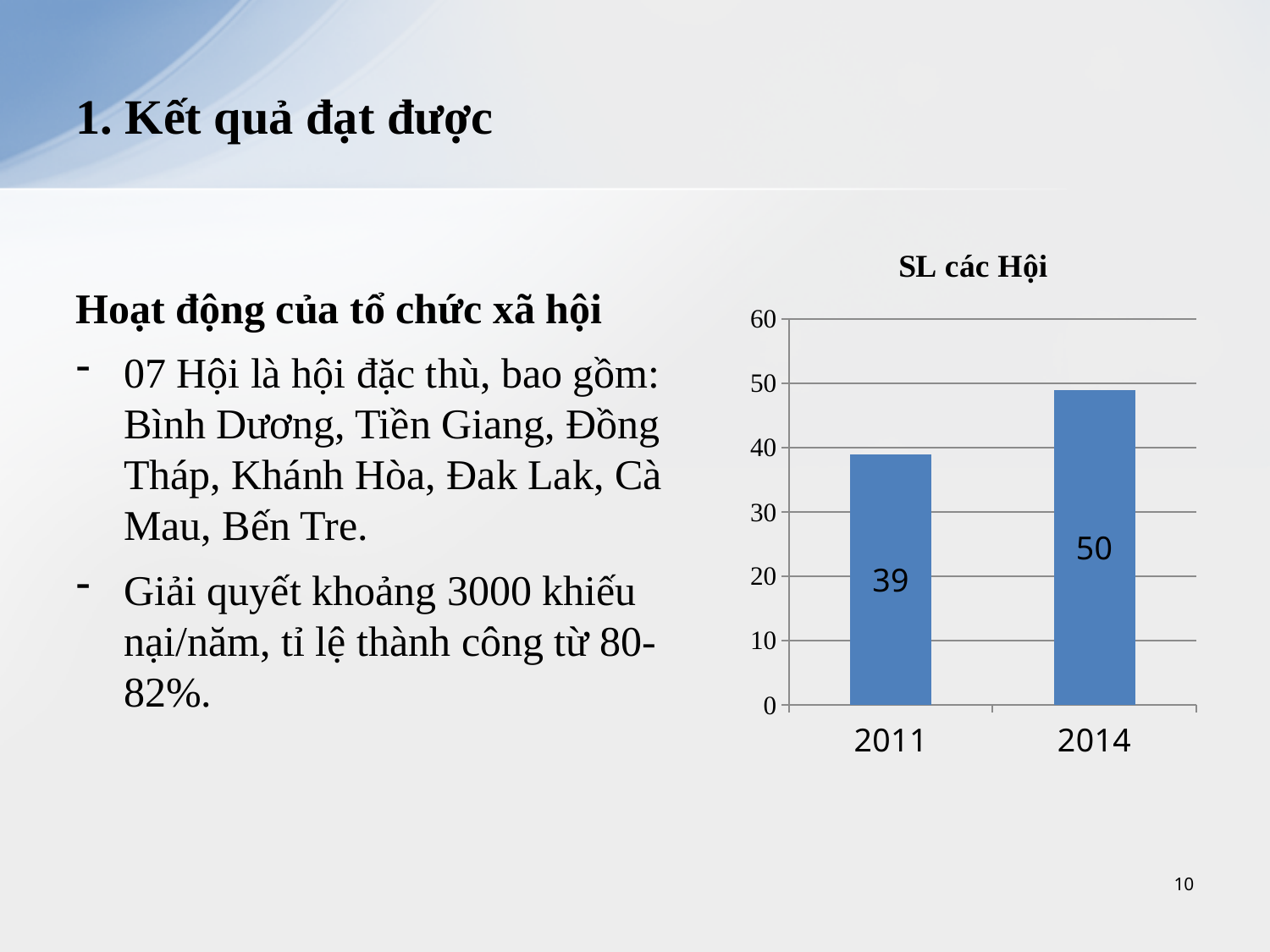
How many categories are shown on the x axis of the chart? 2 Which is larger, the value for 2011 or the value for 2014? 2014 What is the title of the chart? SL các Hội What is the value for 2014 in the chart? 50 Which year has the lowest value in the chart? 2011 What is the difference between the values for 2014 and 2011? 11 Is the value for 2011 greater or less than 40? less Which year has the highest value in the chart? 2014 What is the value for 2011 in the chart? 39 Do the values rise or fall from 2011 to 2014? rise What kind of chart is shown on the slide? bar chart What is the maximum value shown on the y axis of the chart? 60